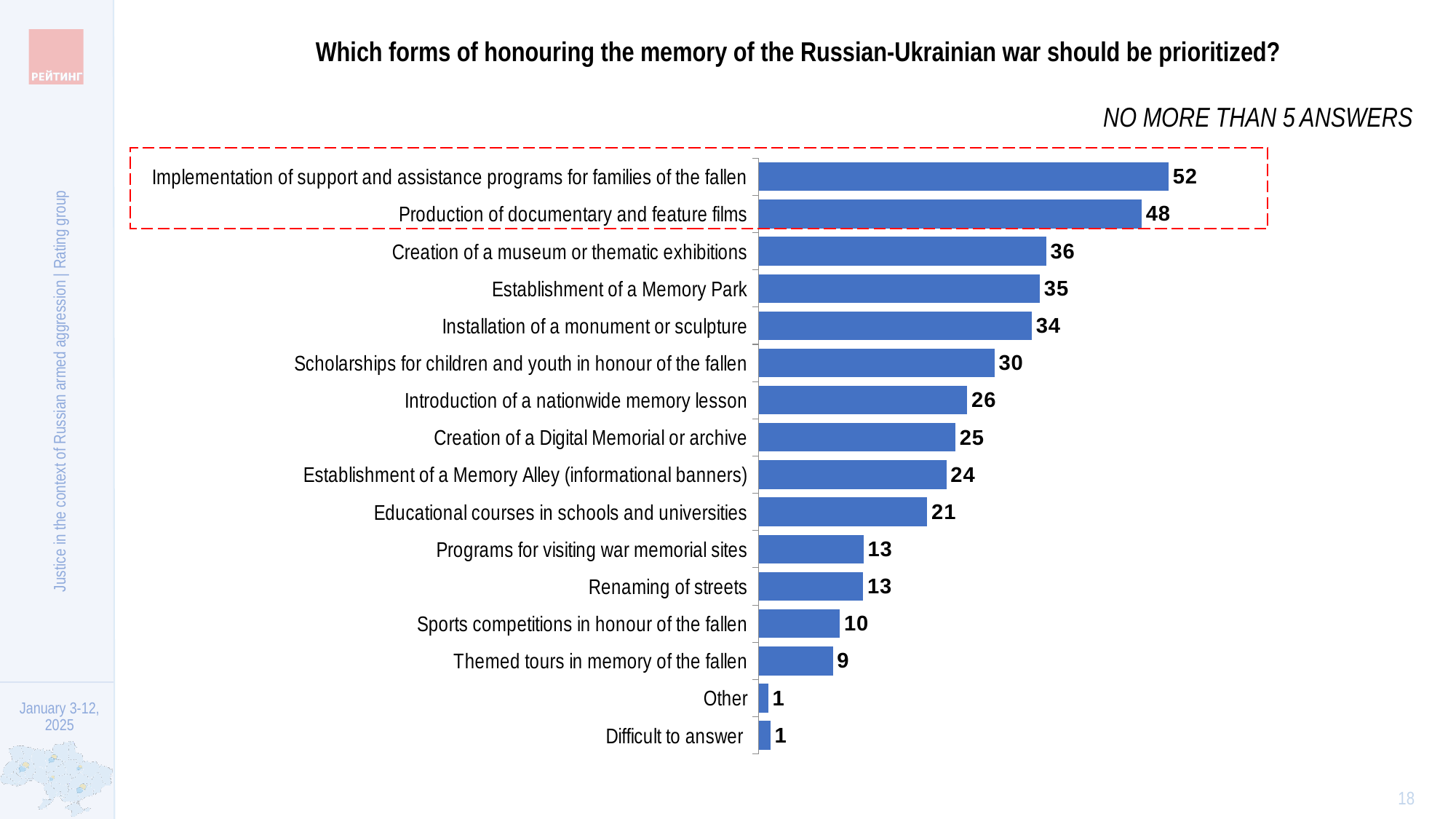
Which two categories are enclosed by the red dashed box? Implementation of support and assistance programs for families of the fallen; Production of documentary and feature films What kind of chart is shown on the slide? Bar chart Which category has the highest value? Implementation of support and assistance programs for families of the fallen What is the difference between the values for "Establishment of a Memory Park" and "Educational courses in schools and universities"? 14 Which is larger: the value for "Installation of a monument or sculpture" or the value for "Introduction of a nationwide memory lesson"? Installation of a monument or sculpture What is the value for "Themed tours in memory of the fallen"? 9 What is the difference between the values for "Implementation of support and assistance programs for families of the fallen" and "Production of documentary and feature films"? 4 How many categories are shown in the chart? 16 What is the value for "Production of documentary and feature films"? 48 What is the value for "Scholarships for children and youth in honour of the fallen"? 30 What is the value for "Creation of a museum or thematic exhibitions"? 36 What is the title of the chart? Which forms of honouring the memory of the Russian-Ukrainian war should be prioritized?